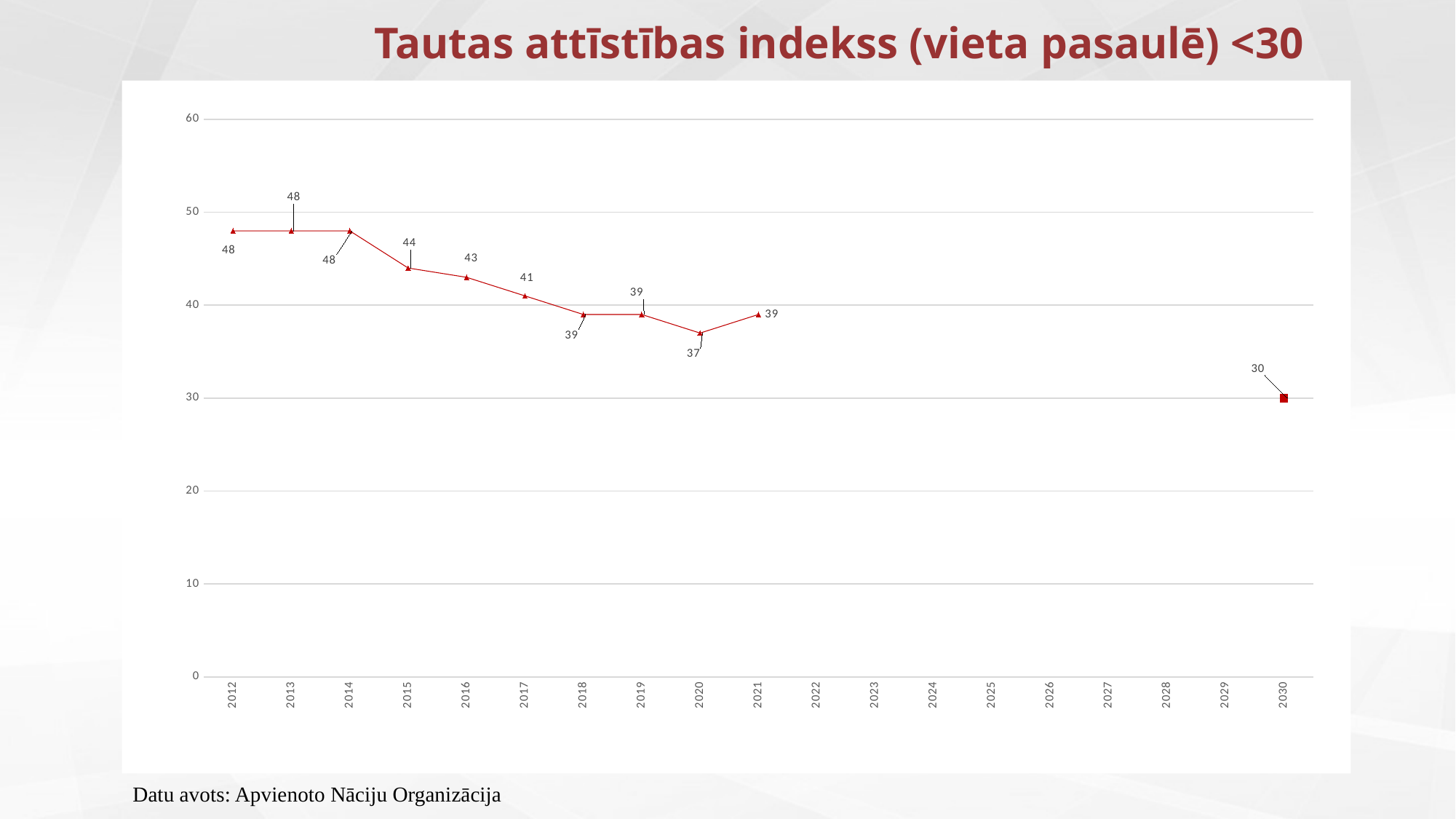
What is the value for 2015? 44 Which year has the lowest plotted value? 2030 Is the value for 2018 greater or less than 40? less Which is larger, the value for 2016 or the value for 2019? 2016 How many years are labelled on the x axis? 19 Do the values generally rise or fall from 2012 to 2020? fall What is the value for 2020? 37 What is the value for 2017? 41 What is the difference between the value for 2021 and the value for 2030? 9 What is the difference between the value for 2012 and the value for 2021? 9 What kind of chart is shown on the slide? line chart What is the value shown for 2030? 30